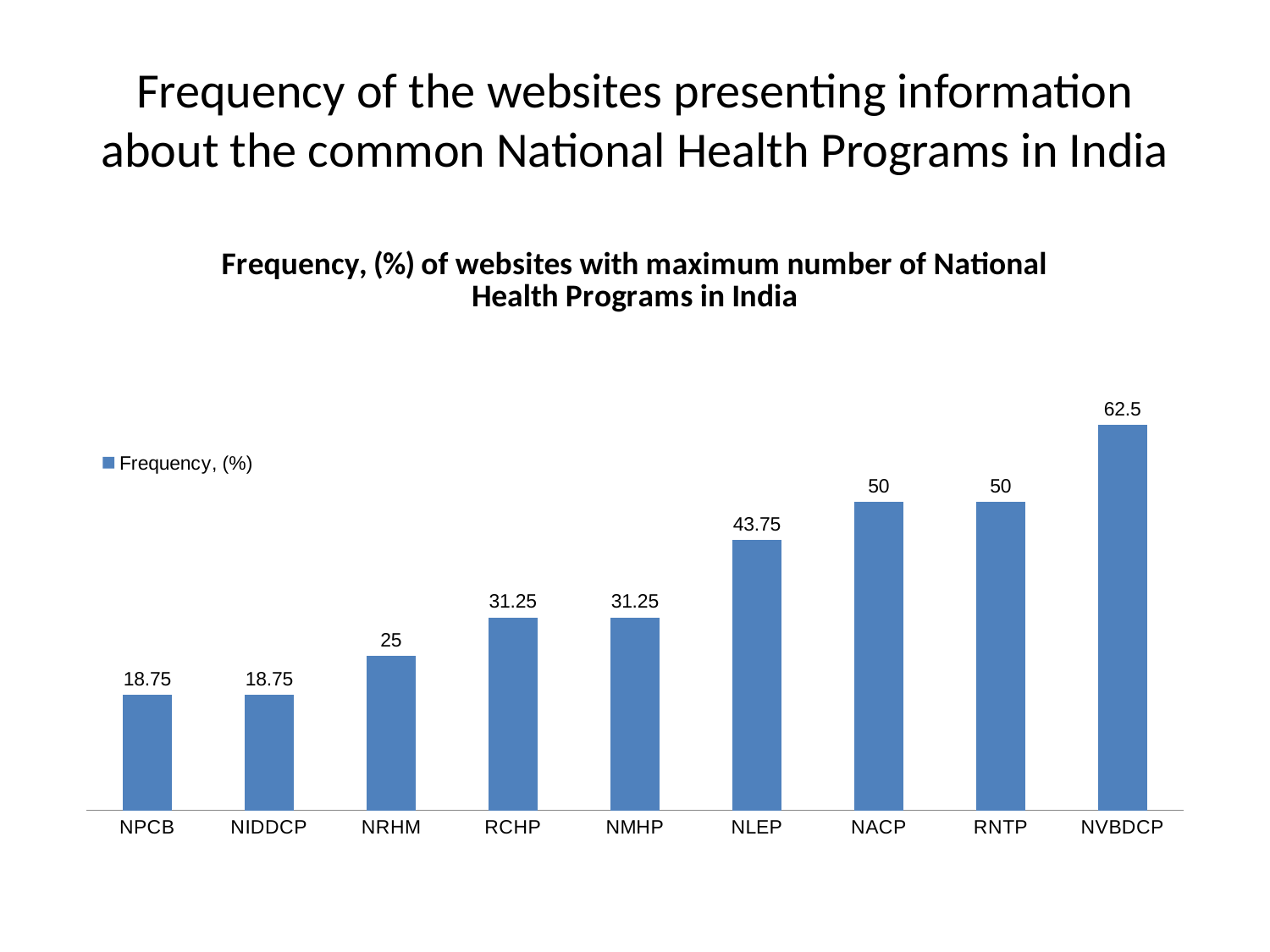
How many categories are shown on the x axis? 9 What kind of chart is shown? bar chart What is the value for NVBDCP? 62.5 Do the values rise or fall from left to right along the x axis? rise How many series does the legend list? 1 What is the difference between the values for RCHP and NRHM? 6.25 What is the value for NRHM? 25 Which is larger, the value for NACP or the value for NMHP? NACP Which category has the highest value? NVBDCP What is the value for NPCB? 18.75 What is the difference between the values for NVBDCP and NLEP? 18.75 What is the value for NLEP? 43.75